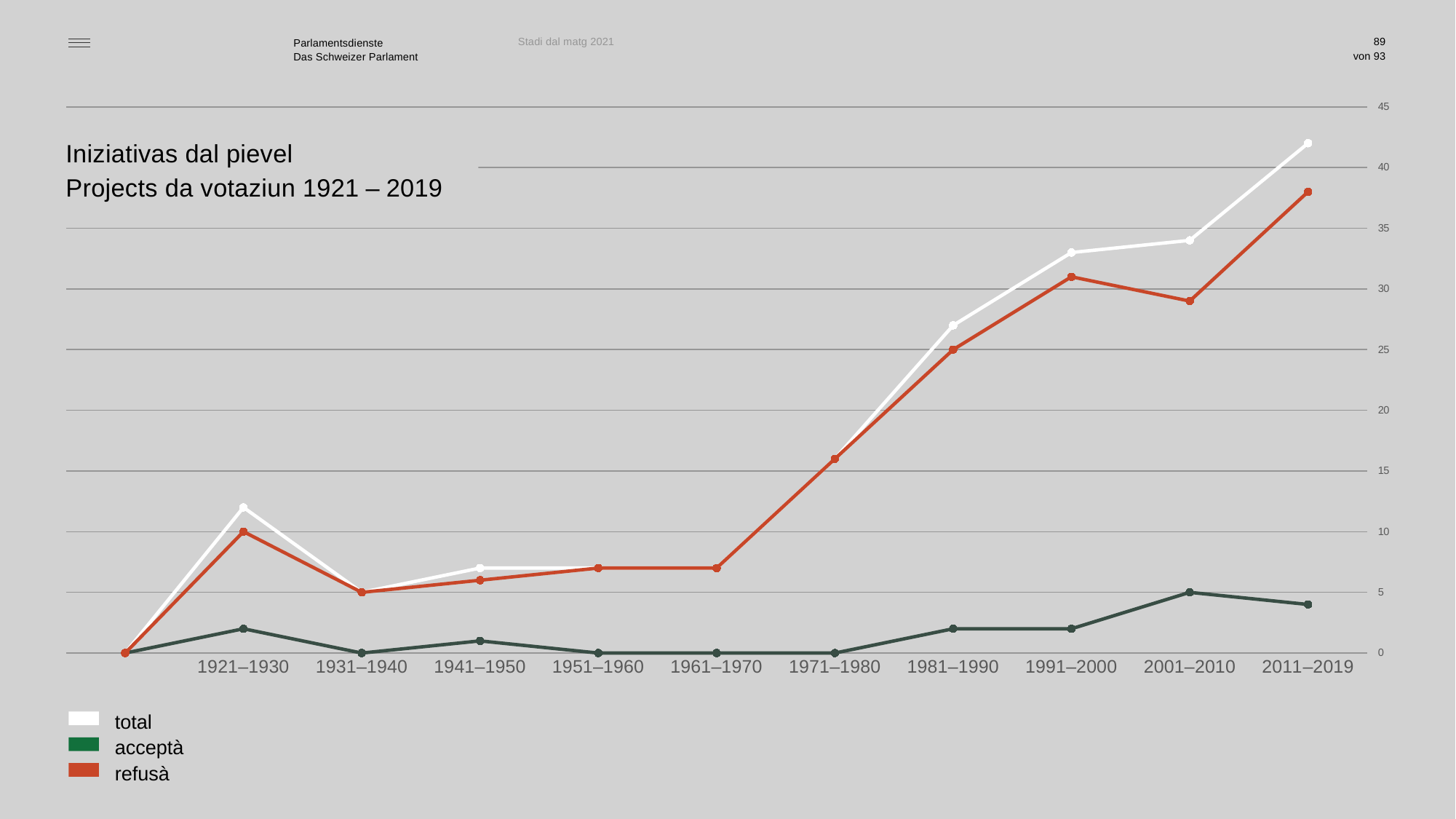
How many series does the legend list? 3 What kind of chart is shown on the slide? line chart In which period does the total series reach its highest value? 2011–2019 What is the value of refusà for 1931–1940? 5 What is the value of refusà for 1921–1930? 10 Which series are listed in the legend? total, acceptà, refusà What is the value of acceptà for 2001–2010? 5 What is the value of refusà for 1981–1990? 25 Is the value of refusà for 1991–2000 greater or less than 30? greater Is the value of total for 2011–2019 greater or less than 40? greater What is the value of acceptà for 1961–1970? 0 Which is larger for 1991–2000, refusà or acceptà? refusà